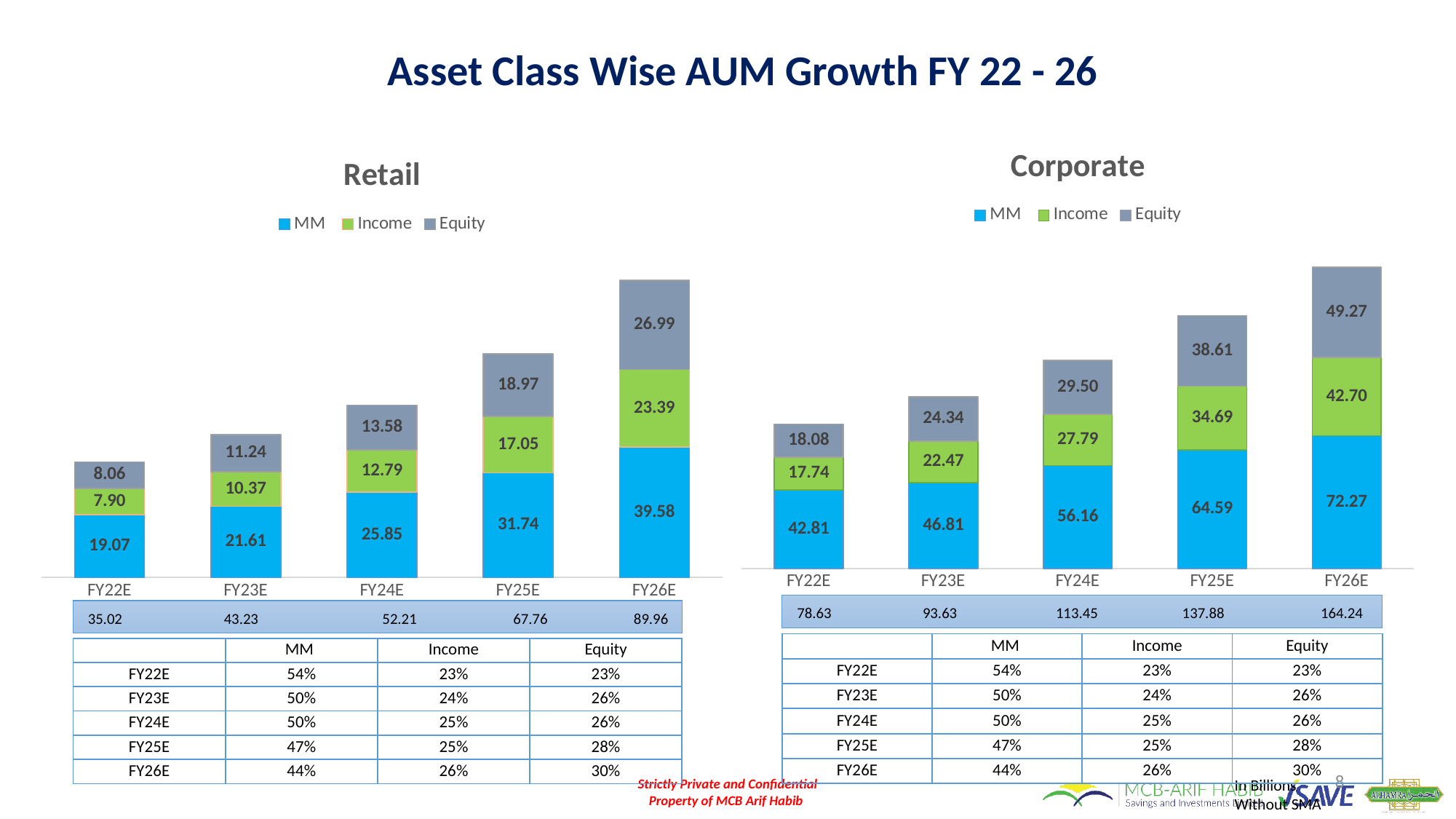
In the Corporate chart, what is the Equity value for FY26E? 49.27 In the Retail chart, what is the Income value for FY22E? 7.90 In the Corporate chart, what is the total of the stacked bar for FY24E? 113.45 In the Retail chart, which is larger for FY25E: the Income value or the Equity value? Equity In the Retail chart, which year has the lowest Equity value? FY22E In the Retail chart, do the MM values rise or fall from FY22E to FY26E? Rise In the Corporate chart, what is the difference between the Income values for FY26E and FY25E? 8.01 How many series does the legend of the Retail chart list? 3 In the Corporate chart, which year has the highest MM value? FY26E How many years are shown on the x axis of the Corporate chart? 5 What type of chart is the Corporate chart? Stacked bar chart In the Retail chart, what is the MM value for FY24E? 25.85